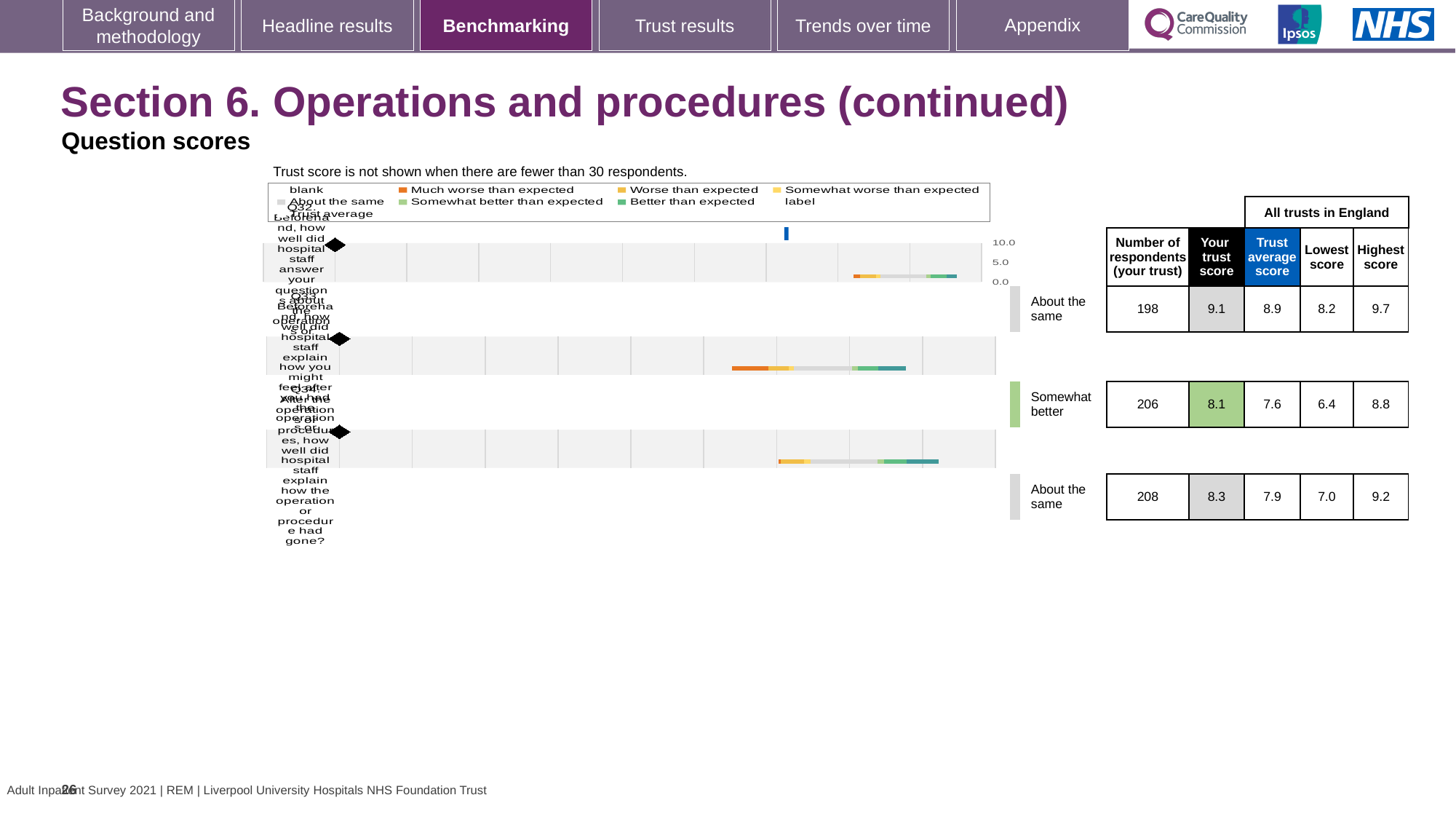
In the benchmarking chart legend, which colour represents 'Much worse than expected'? orange What is the number of respondents for the second question row in the chart? 206 What is the trust average score for the third question row in the chart? 7.9 What is 'Your trust score' for the first question row in the chart? 9.1 For the third question row, which is larger: 'Your trust score' or the trust average score? Your trust score For the second question row, what is the difference between 'Your trust score' and the trust average score? 0.5 What kind of chart is used to show the question scores on this slide? bar chart What is the highest score across all trusts in England for the first question row? 9.7 How many questions (rows) are plotted in the benchmarking chart? 3 Which question row has the highest 'Your trust score'? the first row (9.1) Which question row has the lowest 'Your trust score'? the second row (8.1)